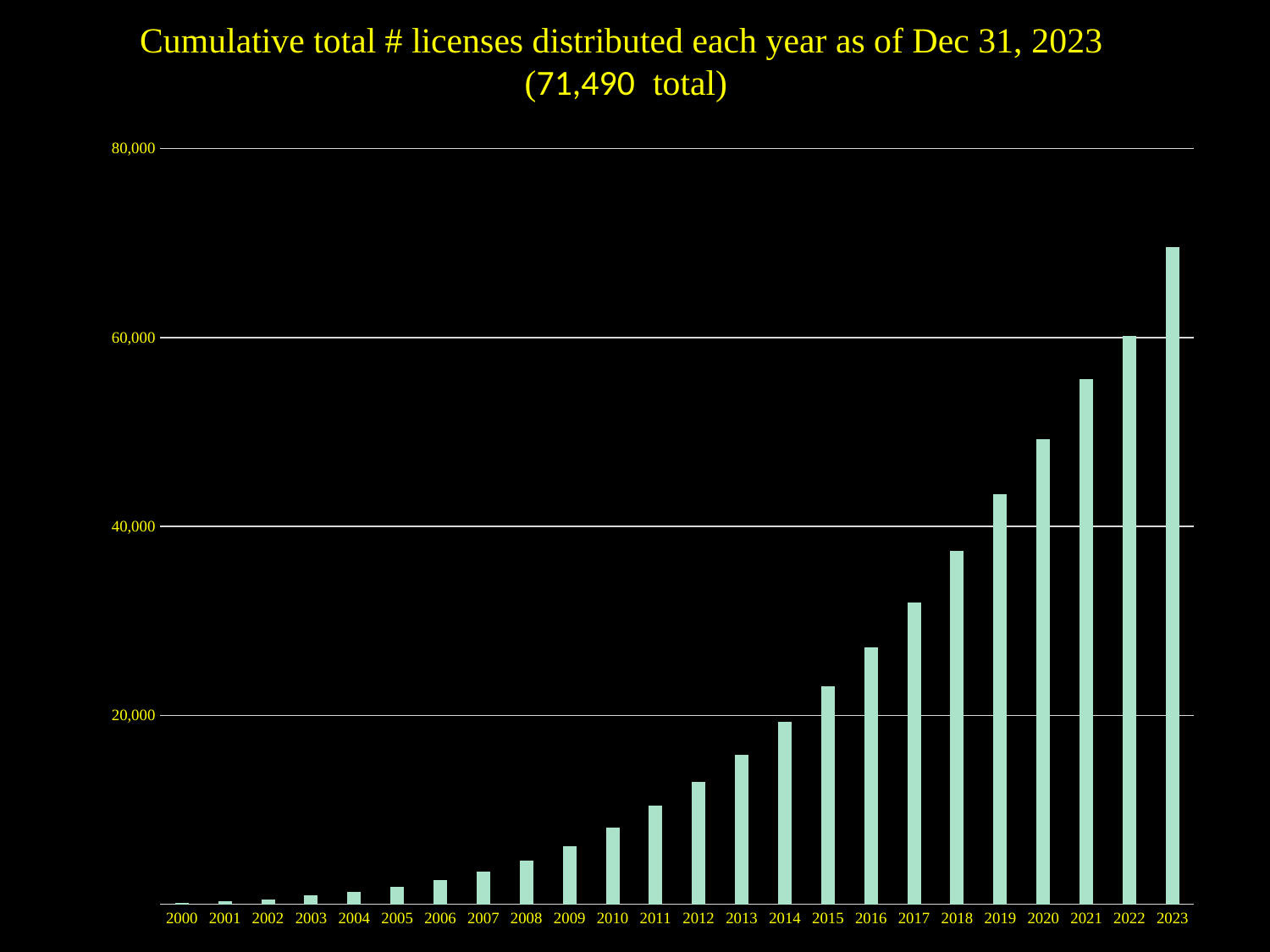
Is the value for 2021 greater or less than 60,000? less Is the value for 2018 greater or less than 40,000? less Is the value for 2013 greater or less than 20,000? less According to the chart title, what is the cumulative total number of licenses as of Dec 31, 2023? 71,490 Which year has the highest cumulative total of licenses? 2023 Do the values rise or fall from 2000 to 2023? rise Which is larger, the value for 2020 or the value for 2016? 2020 How many years are shown on the x axis? 24 What kind of chart is shown on the slide? bar chart Which year has the lowest cumulative total of licenses? 2000